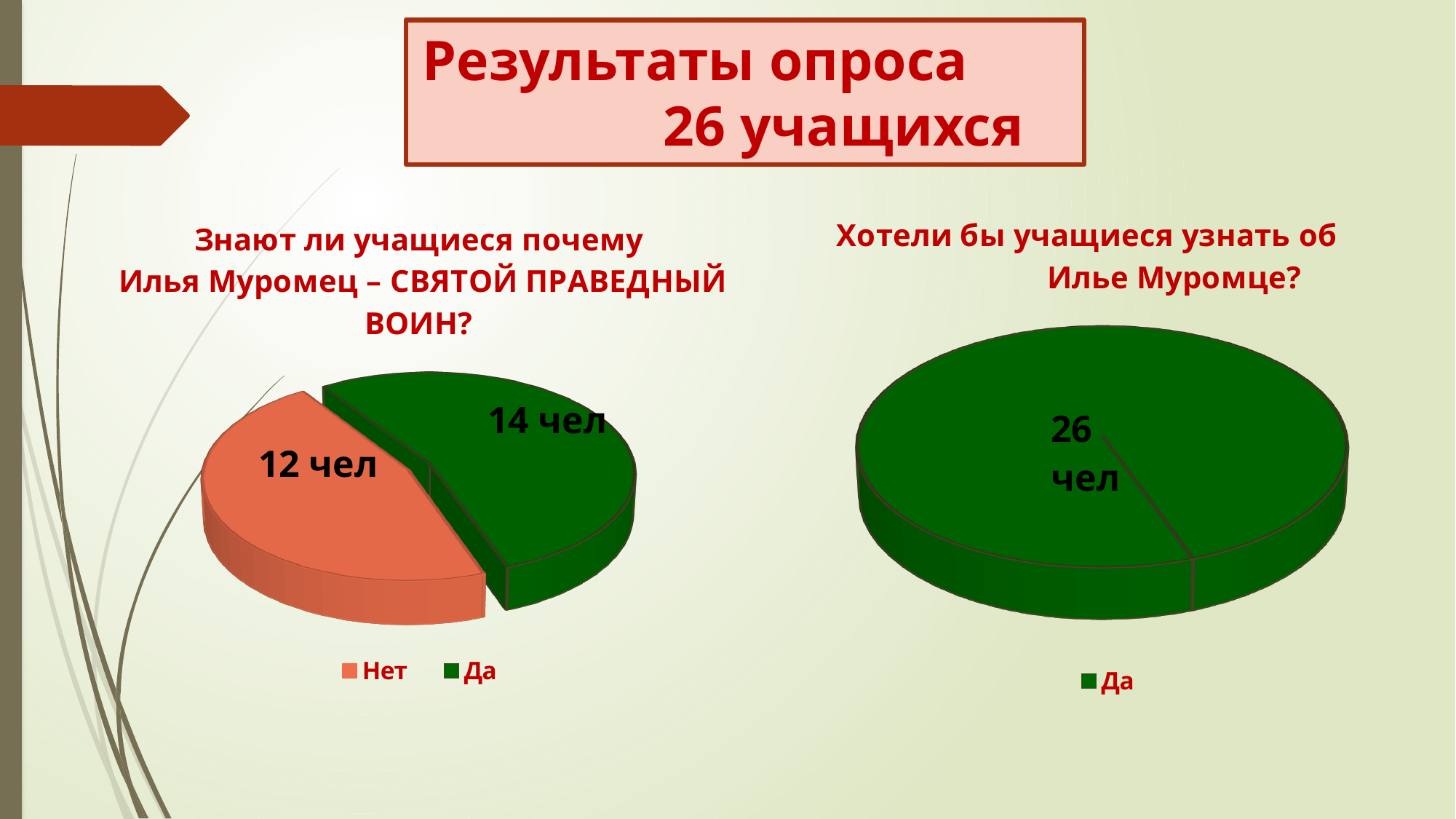
In the left pie chart, is the value for "Нет" larger or smaller than the value for "Да"? smaller How many entries does the legend of the right chart list? 1 What colour is the "Нет" slice in the left pie chart? orange In the left pie chart, which answer has the smaller slice? Нет In the left pie chart, which answer has the larger slice? Да In the left pie chart, how many students answered "Да"? 14 чел In the left pie chart, what is the difference between the "Да" and "Нет" values? 2 чел In the left pie chart, how many students answered "Нет"? 12 чел In the right pie chart, what value is shown for "Да"? 26 чел How many slices does the left pie chart have? 2 What type of chart is used on the left side of the slide? pie chart In the right pie chart, what share of the pie does "Да" take? 100%